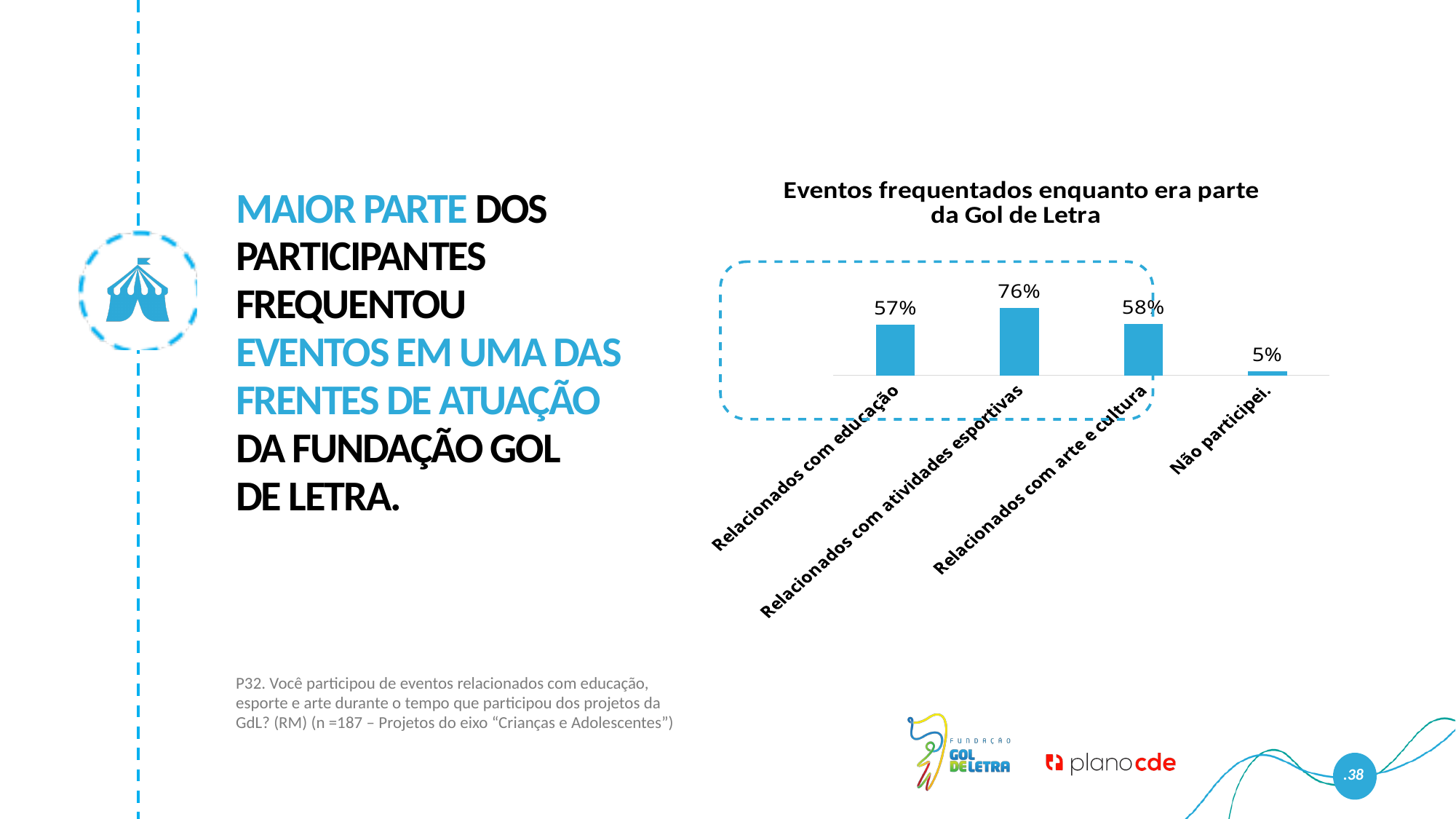
What kind of chart is shown on the slide? Bar chart What is the value for "Relacionados com atividades esportivas"? 76% What is the title of the chart? Eventos frequentados enquanto era parte da Gol de Letra Which category has the highest value? Relacionados com atividades esportivas What is the value for "Não participei."? 5% What is the value for "Relacionados com educação"? 57% How many categories are shown in the chart? 4 What is the difference between the values for "Relacionados com arte e cultura" and "Não participei."? 53% What is the difference between the values for "Relacionados com atividades esportivas" and "Relacionados com educação"? 19% Which is larger: the value for "Relacionados com atividades esportivas" or the value for "Relacionados com arte e cultura"? Relacionados com atividades esportivas Which category has the lowest value? Não participei. What is the value for "Relacionados com arte e cultura"? 58%